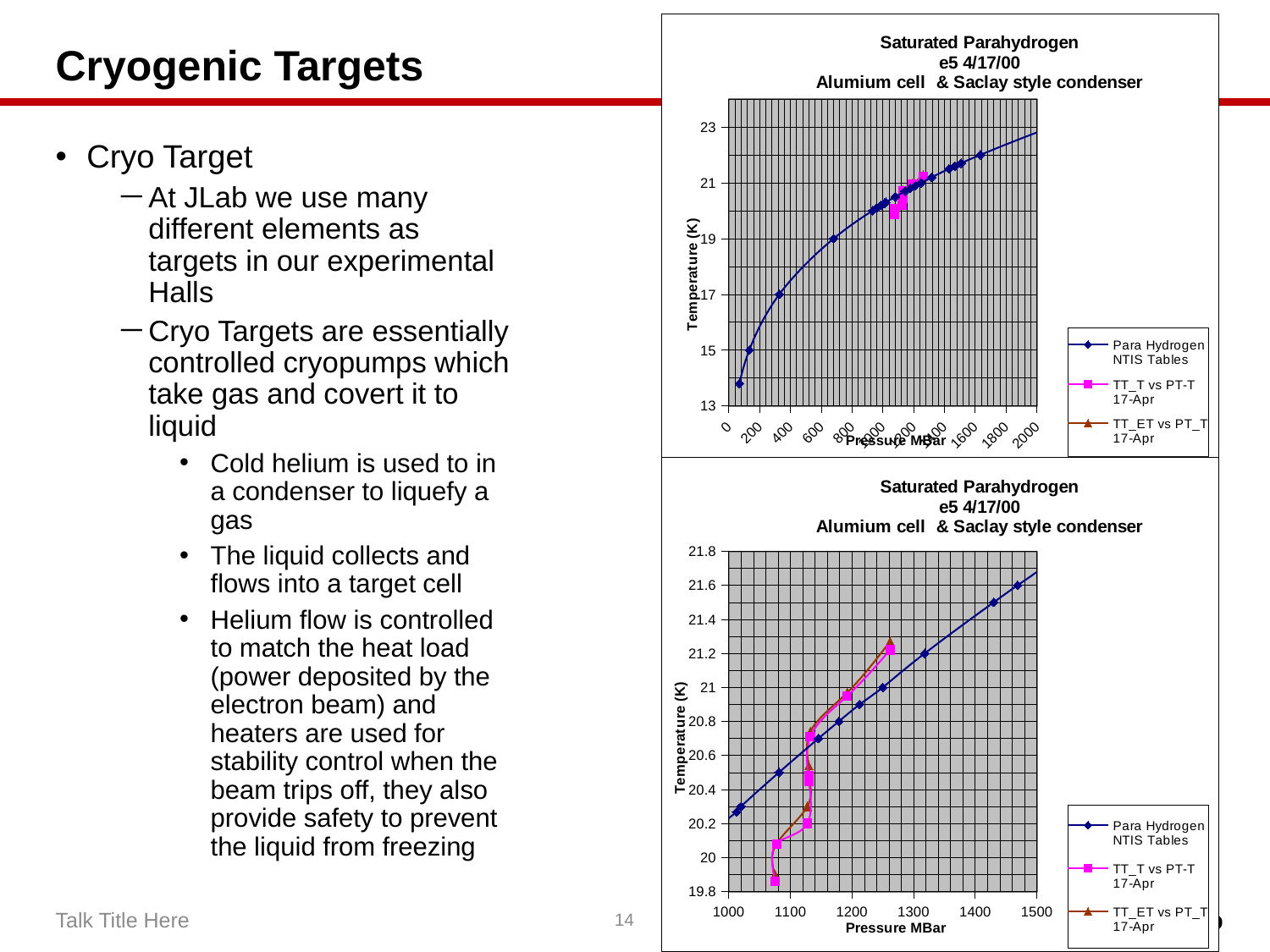
In the bottom chart, is the Para Hydrogen NTIS Tables temperature at 1000 MBar greater or less than 20.6 K? less What is the label of the y axis on the top chart? Temperature (K) In the top chart, is the Para Hydrogen NTIS Tables temperature at 200 MBar greater or less than 17 K? less In the bottom chart, does the Para Hydrogen NTIS Tables temperature rise or fall as pressure increases from 1000 to 1500 MBar? rise In the bottom chart, is the Para Hydrogen NTIS Tables temperature at 1500 MBar greater or less than 21.4 K? greater What kind of chart is the top chart on the slide? line chart What is the label of the x axis on the bottom chart? Pressure MBar How many series does the legend of the top chart list? 3 In the top chart, does the Para Hydrogen NTIS Tables temperature rise or fall as pressure increases? rise How many series does the legend of the bottom chart list? 3